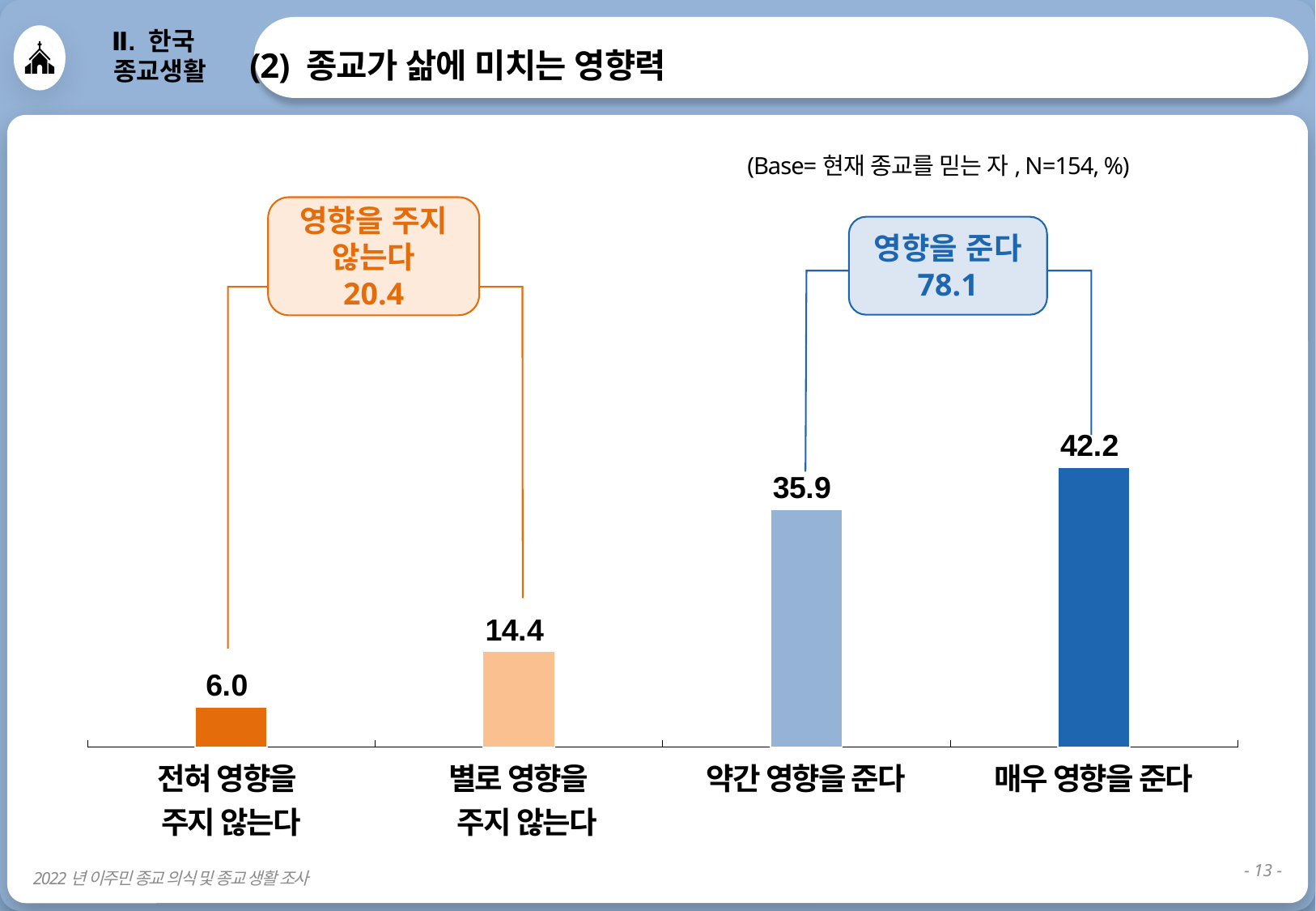
Which category has the highest value? 매우 영향을 준다 What kind of chart is shown on the slide? Bar chart Which is larger, 별로 영향을 주지 않는다 or 약간 영향을 준다? 약간 영향을 준다 Do the values rise or fall from left to right along the x axis? Rise What is the value for 전혀 영향을 주지 않는다? 6.0 What is the value for 매우 영향을 준다? 42.2 How many categories are shown in the chart? 4 What combined value is shown in the box labelled 영향을 준다? 78.1 Which category has the lowest value? 전혀 영향을 주지 않는다 What is the value for 별로 영향을 주지 않는다? 14.4 What is the value for 약간 영향을 준다? 35.9 What is the difference between 매우 영향을 준다 and 약간 영향을 준다? 6.3